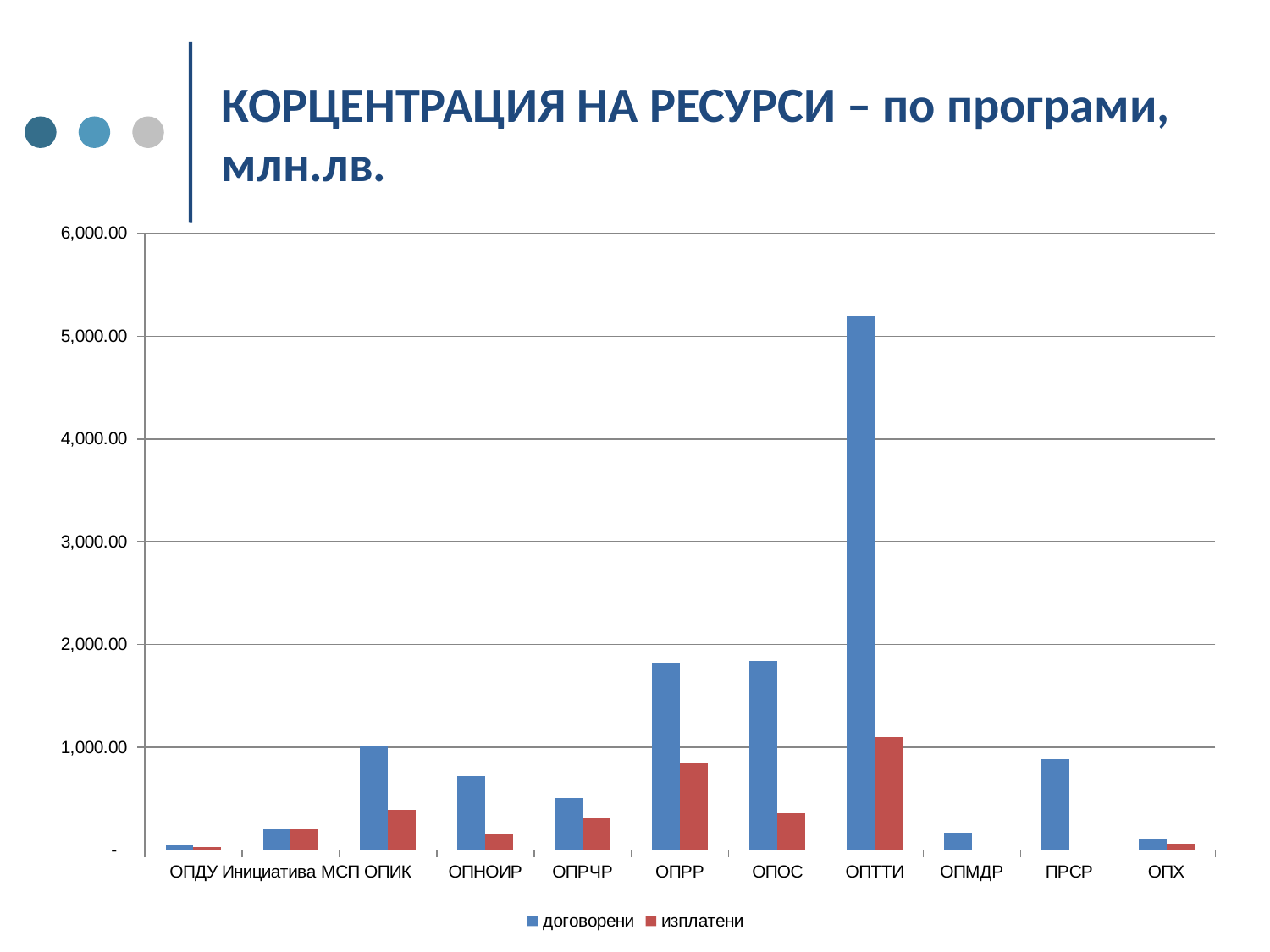
Which is larger: the договорени value for ОПИК or the договорени value for ОПНОИР? ОПИК Is the договорени value for ОПРР greater or less than 1,000.00? greater How many series does the legend list? 2 Which programme has the highest value for изплатени? ОПТТИ Which is larger: the изплатени value for ОПРР or the изплатени value for ОПОС? ОПРР Is the договорени value for ОПТТИ greater or less than 5,000.00? greater What kind of chart is shown on the slide? bar chart Which programme has the highest value for договорени? ОПТТИ How many programme categories are shown on the x axis? 11 Which series is shown in blue in the legend? договорени Is the договорени value for ОПНОИР greater or less than 1,000.00? less